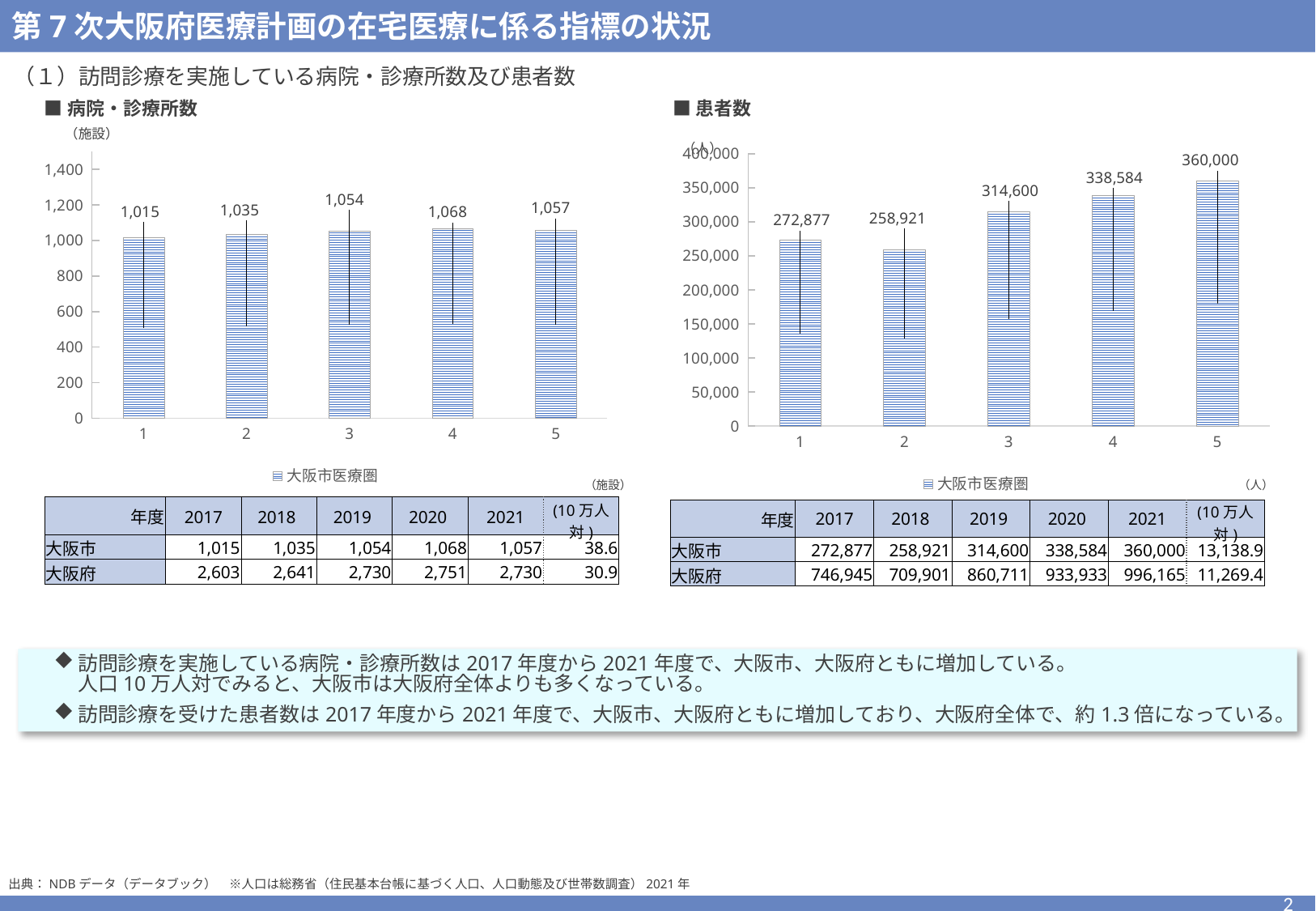
In the 病院・診療所数 chart on the left, which category has the lowest value? 1 What type of chart is the 病院・診療所数 chart on the left? bar chart In the 患者数 chart on the right, which category has the lowest value? 2 In the 患者数 chart on the right, what is the difference between the values for category 4 and category 3? 23,984 In the 患者数 chart on the right, what is the value for category 5? 360,000 How many bars are plotted in the 患者数 chart on the right? 5 In the 病院・診療所数 chart on the left, what is the value for category 4? 1,068 In the 病院・診療所数 chart on the left, what is the difference between the values for category 5 and category 1? 42 In the 患者数 chart on the right, what is the value for category 3? 314,600 In the 患者数 chart on the right, which is larger, the value for category 1 or category 2? category 1 In the 病院・診療所数 chart on the left, which category has the highest value? 4 In the 病院・診療所数 chart on the left, what is the value for category 1? 1,015